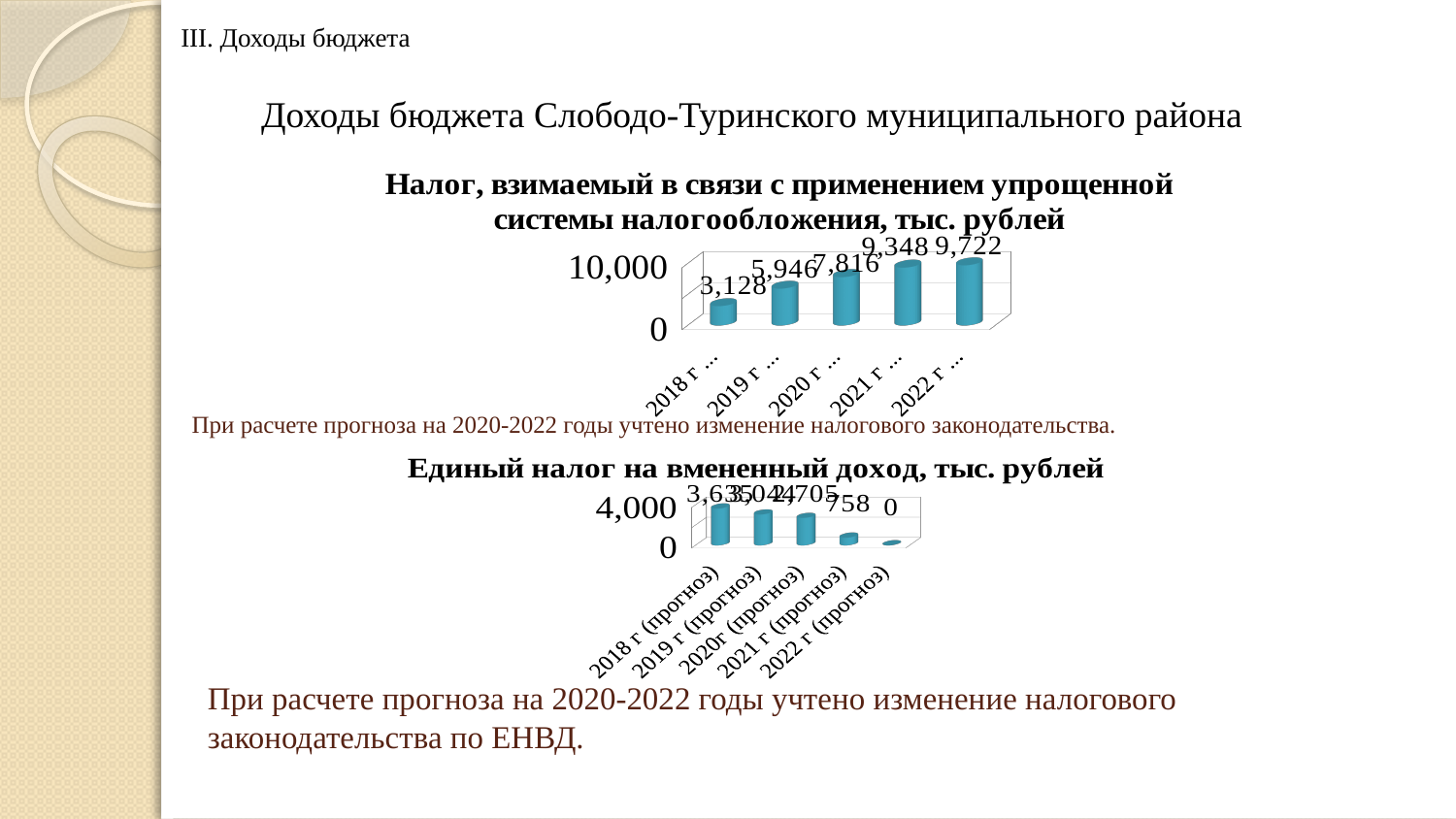
In the top chart (Налог, взимаемый в связи с применением упрощенной системы налогообложения), which year has the highest value? 2022 In the bottom chart (Единый налог на вмененный доход), what is the value for 2022 г (прогноз)? 0 In the top chart (Налог, взимаемый в связи с применением упрощенной системы налогообложения), what is the difference between the 2019 and 2018 values? 2,818 How many years are shown in the top chart (Налог, взимаемый в связи с применением упрощенной системы налогообложения)? 5 In the top chart (Налог, взимаемый в связи с применением упрощенной системы налогообложения), what is the value for 2018? 3,128 In the top chart (Налог, взимаемый в связи с применением упрощенной системы налогообложения), what is the value for 2020? 7,816 In the top chart (Налог, взимаемый в связи с применением упрощенной системы налогообложения), do the values rise or fall from 2018 to 2022? rise In the bottom chart (Единый налог на вмененный доход), do the values rise or fall from 2018 to 2022? fall In the top chart (Налог, взимаемый в связи с применением упрощенной системы налогообложения), which year has the lowest value? 2018 In the top chart (Налог, взимаемый в связи с применением упрощенной системы налогообложения), what is the value for 2022? 9,722 In the bottom chart (Единый налог на вмененный доход), what is the value for 2021 г (прогноз)? 758 What kind of chart is the bottom chart (Единый налог на вмененный доход)? bar chart